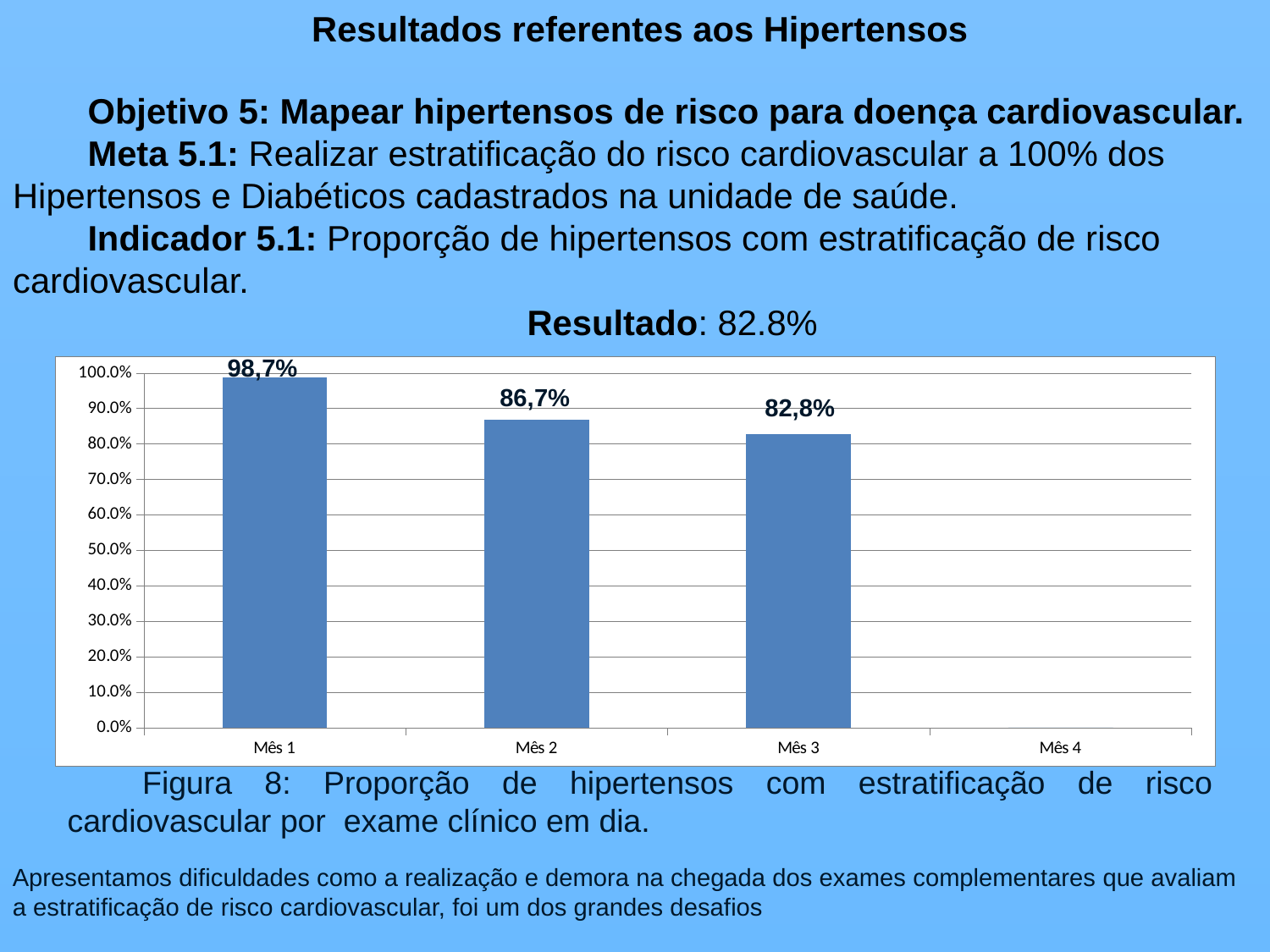
What is the difference between the values for Mês 2 and Mês 3? 4,0% What is the value for Mês 2? 86,7% How many months have a bar plotted in the chart? 3 Which month has the highest value? Mês 1 Do the values rise or fall from Mês 1 to Mês 3? fall What is the value for Mês 1? 98,7% Is the value for Mês 3 greater or less than 90.0%? less Which of the months with a plotted bar has the lowest value? Mês 3 What is the value for Mês 3? 82,8% Which is larger, the value for Mês 2 or the value for Mês 3? Mês 2 What kind of chart is shown on the slide? bar chart What is the difference between the values for Mês 1 and Mês 2? 12,0%